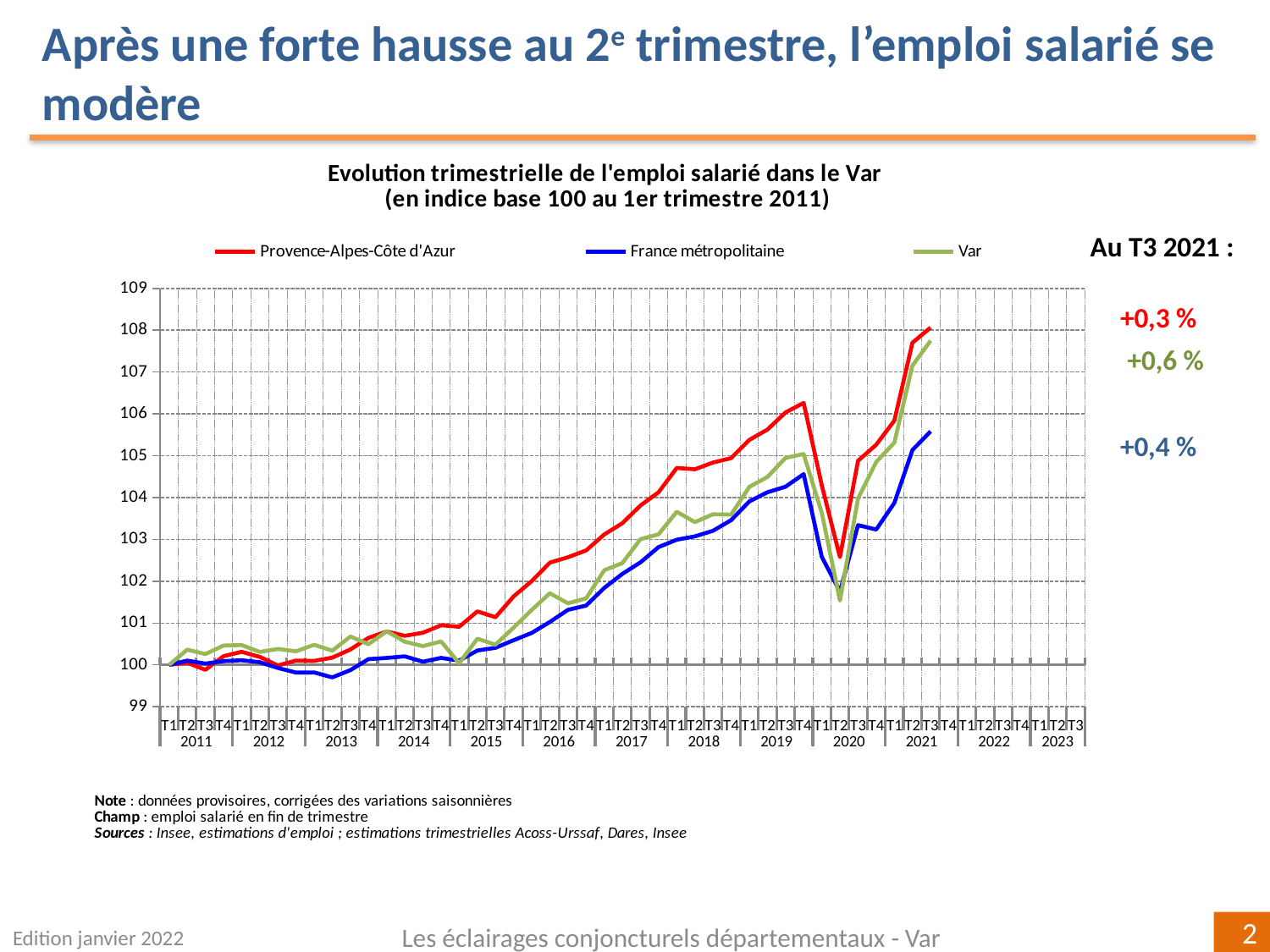
Is the index value for Var at T2 2020 greater or less than 102? less Which series is drawn in red? Provence-Alpes-Côte d'Azur What is the title of the chart? Evolution trimestrielle de l'emploi salarié dans le Var (en indice base 100 au 1er trimestre 2011) According to the annotation, what is the change at T3 2021 for Provence-Alpes-Côte d'Azur? +0,3 % Which series has the lowest index value at T3 2021? France métropolitaine How many series does the legend list? 3 What kind of chart is shown on the slide? line chart Does the Provence-Alpes-Côte d'Azur index rise or fall between T4 2019 and T2 2020? fall Which series has the highest index value at T3 2021? Provence-Alpes-Côte d'Azur According to the annotation, what is the change at T3 2021 for Var? +0,6 % Is the index value for France métropolitaine at T3 2021 greater or less than 105? greater According to the annotation, what is the change at T3 2021 for France métropolitaine? +0,4 %